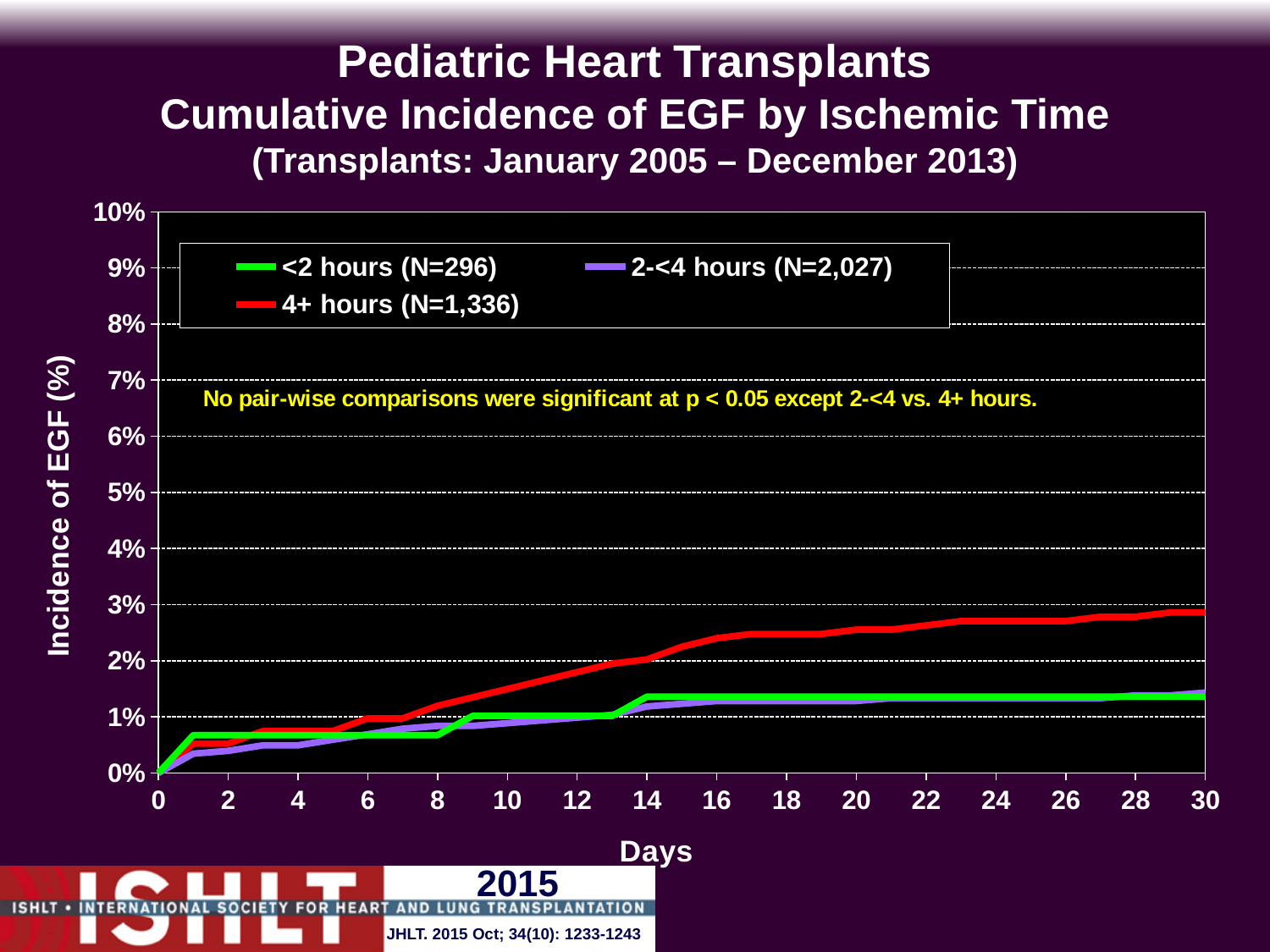
Is the value for the 2-<4 hours series at day 30 greater or less than 2%? less Is the value for the <2 hours series at day 30 greater or less than 2%? less What is the highest tick value shown on the y axis? 10% How many series does the legend list? 3 Is the value for the 4+ hours series at day 30 greater or less than 2%? greater At day 10, which series has the larger value: 4+ hours or <2 hours? 4+ hours Which series has the highest cumulative incidence of EGF at day 30? 4+ hours (N=1,336) What kind of chart is shown on the slide? line chart What is the label of the x axis? Days Do the values for the 4+ hours series rise or fall as days increase? rise